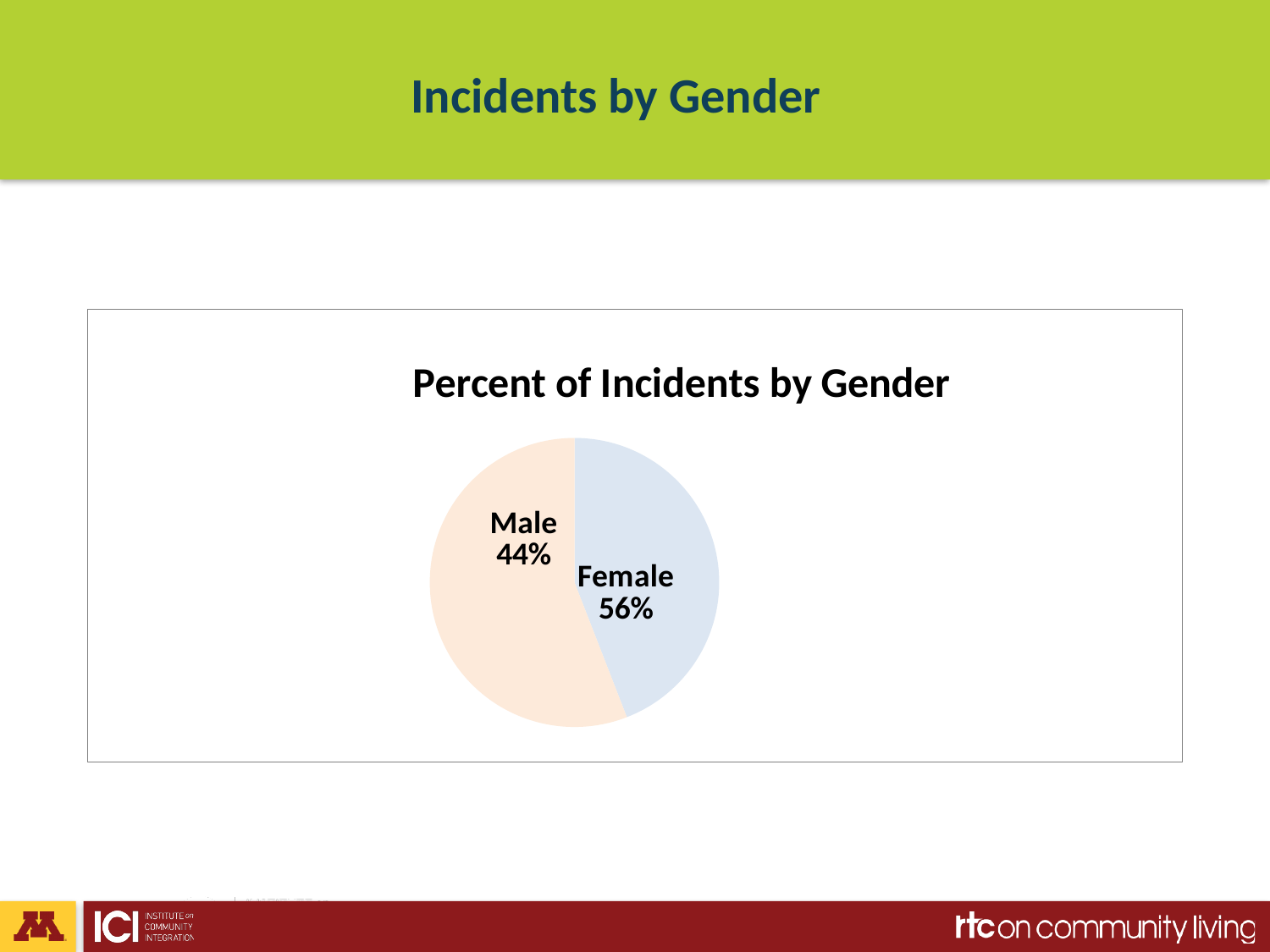
What is the title of the chart? Percent of Incidents by Gender Is the Male share of incidents greater or less than 50%? less What percentage of incidents are attributed to Female? 56% What kind of chart is shown on the slide? pie chart What is the difference in percentage points between the Female and Male shares of incidents? 12 What share of the pie does the Male slice represent? 44% Which gender has the larger share of incidents? Female How many categories are shown in the pie chart? 2 Which gender has the smaller share of incidents? Male What percentage of incidents are attributed to Male? 44% Is the share of incidents for Female larger or smaller than the share for Male? larger